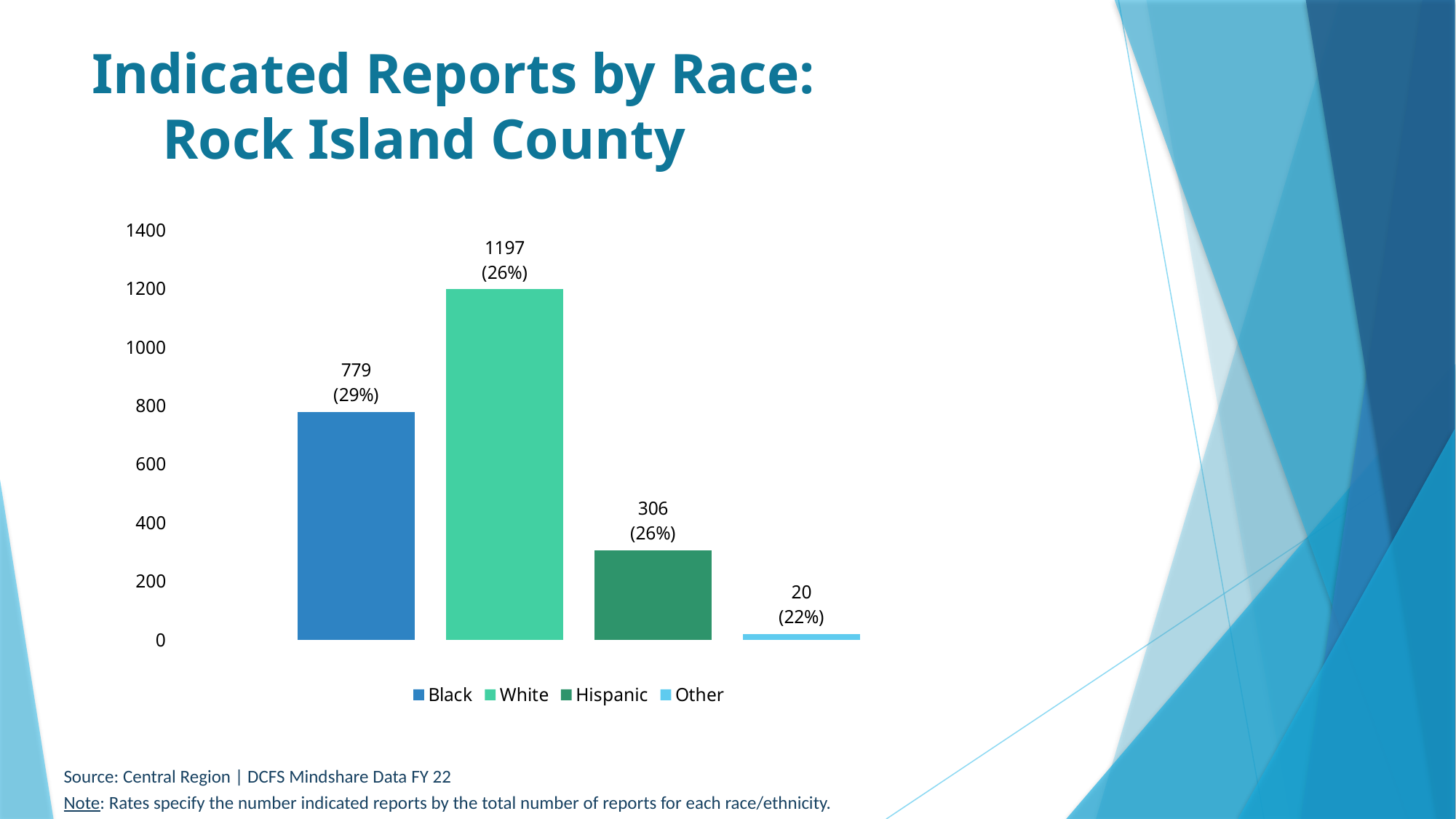
What is the difference in indicated reports between White and Black? 418 Which has more indicated reports, Black or Hispanic? Black How many indicated reports are shown for White? 1197 What is the title of the slide containing the chart? Indicated Reports by Race: Rock Island County How many race/ethnicity categories are plotted in the chart? 4 What percentage rate is shown for Hispanic? 26% What percentage rate is shown for Other? 22% Which race/ethnicity has the lowest number of indicated reports? Other What is the difference in indicated reports between Hispanic and Other? 286 What kind of chart is shown on the slide? Bar chart How many indicated reports are shown for Black? 779 Which race/ethnicity has the highest number of indicated reports? White